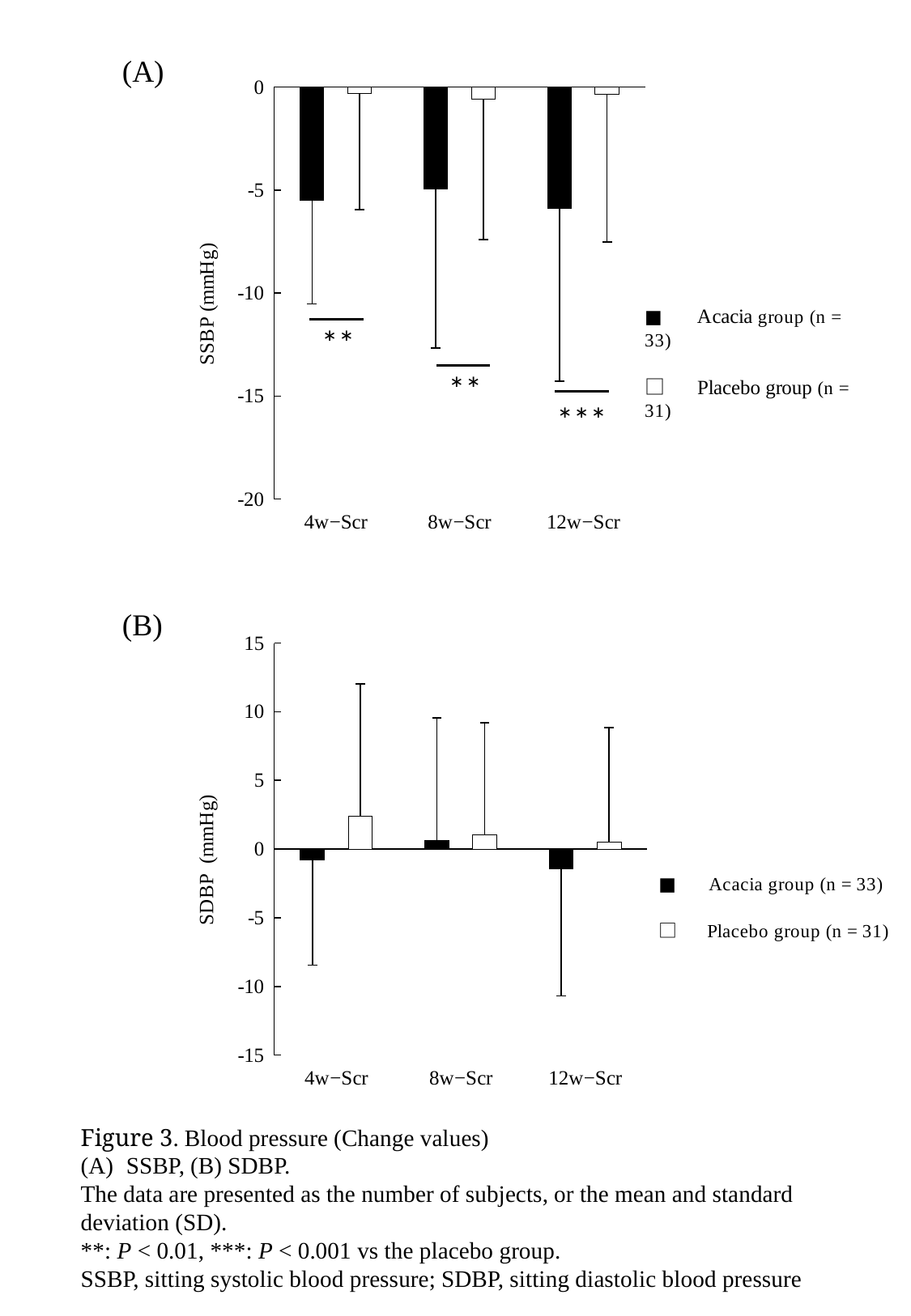
In chart (B), is the value for the Placebo group at 4w−Scr greater or less than 0? greater How many series does the legend of chart (B) list? 2 In chart (B), at 12w−Scr, which group's bar is higher, Acacia or Placebo? Placebo group In chart (A), is the value for the Acacia group at 12w−Scr greater or less than -10? greater In chart (A), at 4w−Scr, which group's bar extends further below zero, Acacia or Placebo? Acacia group In chart (B), is the value for the Acacia group at 12w−Scr greater or less than 0? less How many categories are shown on the x axis of chart (A)? 3 What kind of chart is chart (A)? bar chart What is the y-axis label of chart (A)? SSBP (mmHg) In chart (A), which category is marked with three asterisks (***)? 12w−Scr